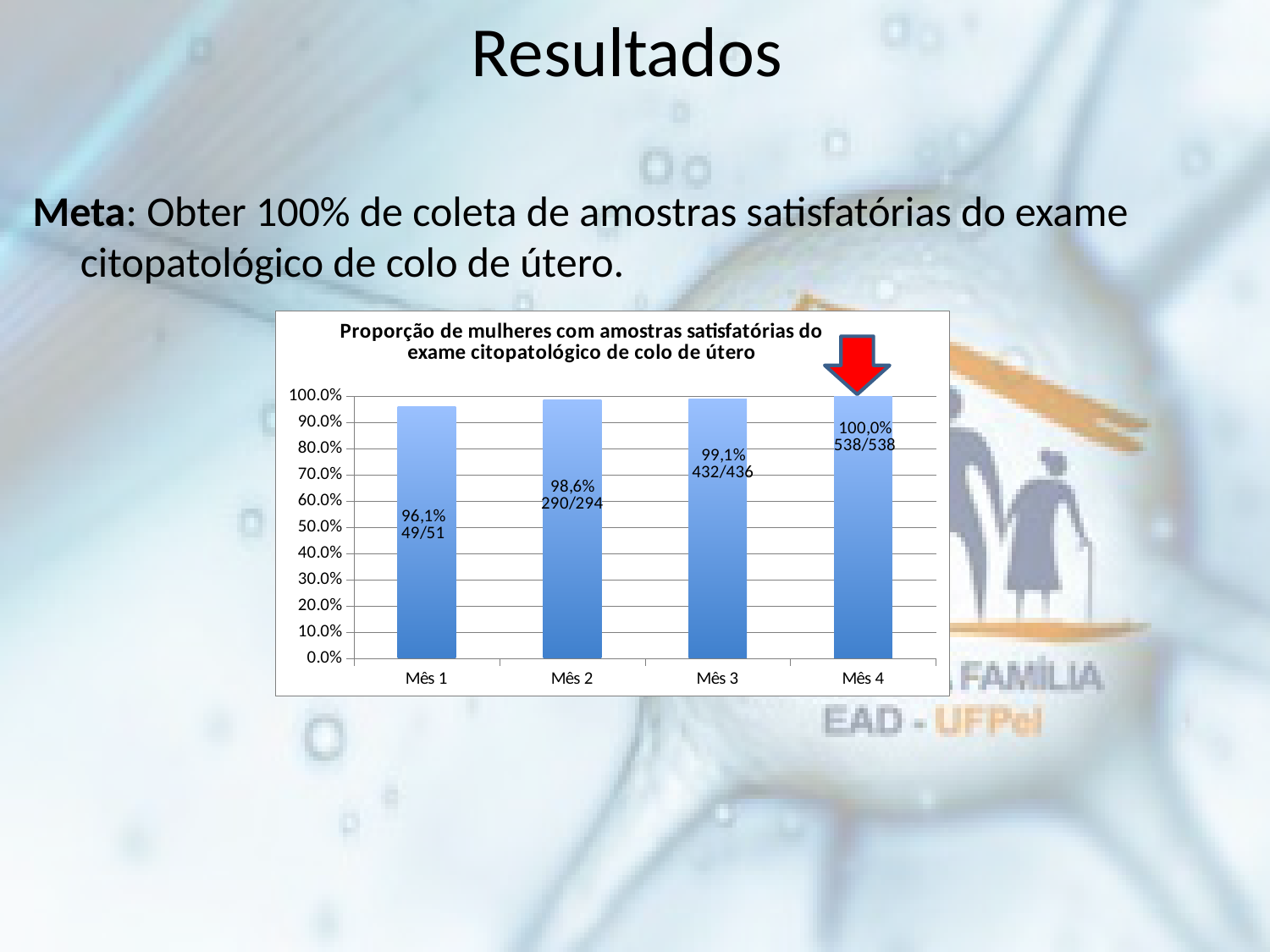
What fraction is shown on the bar for Mês 3? 432/436 Which month has the highest value? Mês 4 What kind of chart is shown? Bar chart What is the difference between the values for Mês 4 and Mês 1? 3,9% What is the value for Mês 1? 96,1% What is the value for Mês 3? 99,1% What is the value for Mês 2? 98,6% Which is larger, the value for Mês 2 or the value for Mês 3? Mês 3 What is the value for Mês 4? 100,0% How many months are shown on the x axis? 4 Which month has the lowest value? Mês 1 Do the values rise or fall from Mês 1 to Mês 4? Rise